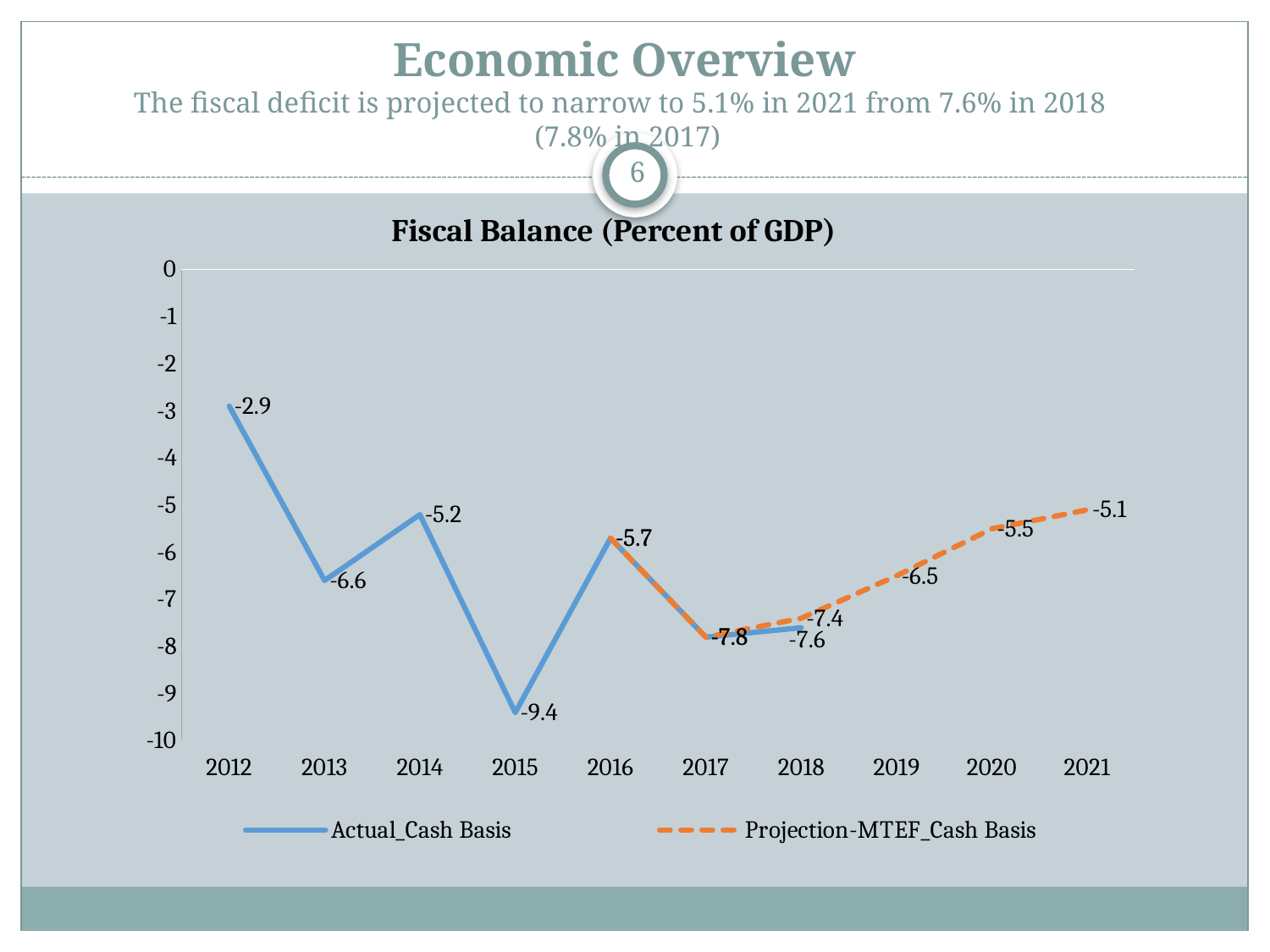
In which year is the Actual_Cash Basis fiscal balance highest? 2012 What is the Actual_Cash Basis value for 2012? -2.9 What is the difference between the Actual_Cash Basis values for 2014 and 2015? 4.2 How many series does the legend list? 2 What is the title of the chart? Fiscal Balance (Percent of GDP) What is the Projection-MTEF_Cash Basis value for 2021? -5.1 In which year is the fiscal balance lowest? 2015 What type of chart is shown on the slide? Line chart What is the Actual_Cash Basis value for 2015? -9.4 How many years are shown on the x axis? 10 What is the Projection-MTEF_Cash Basis value for 2019? -6.5 Does the Projection-MTEF_Cash Basis line rise or fall from 2018 to 2021? Rise